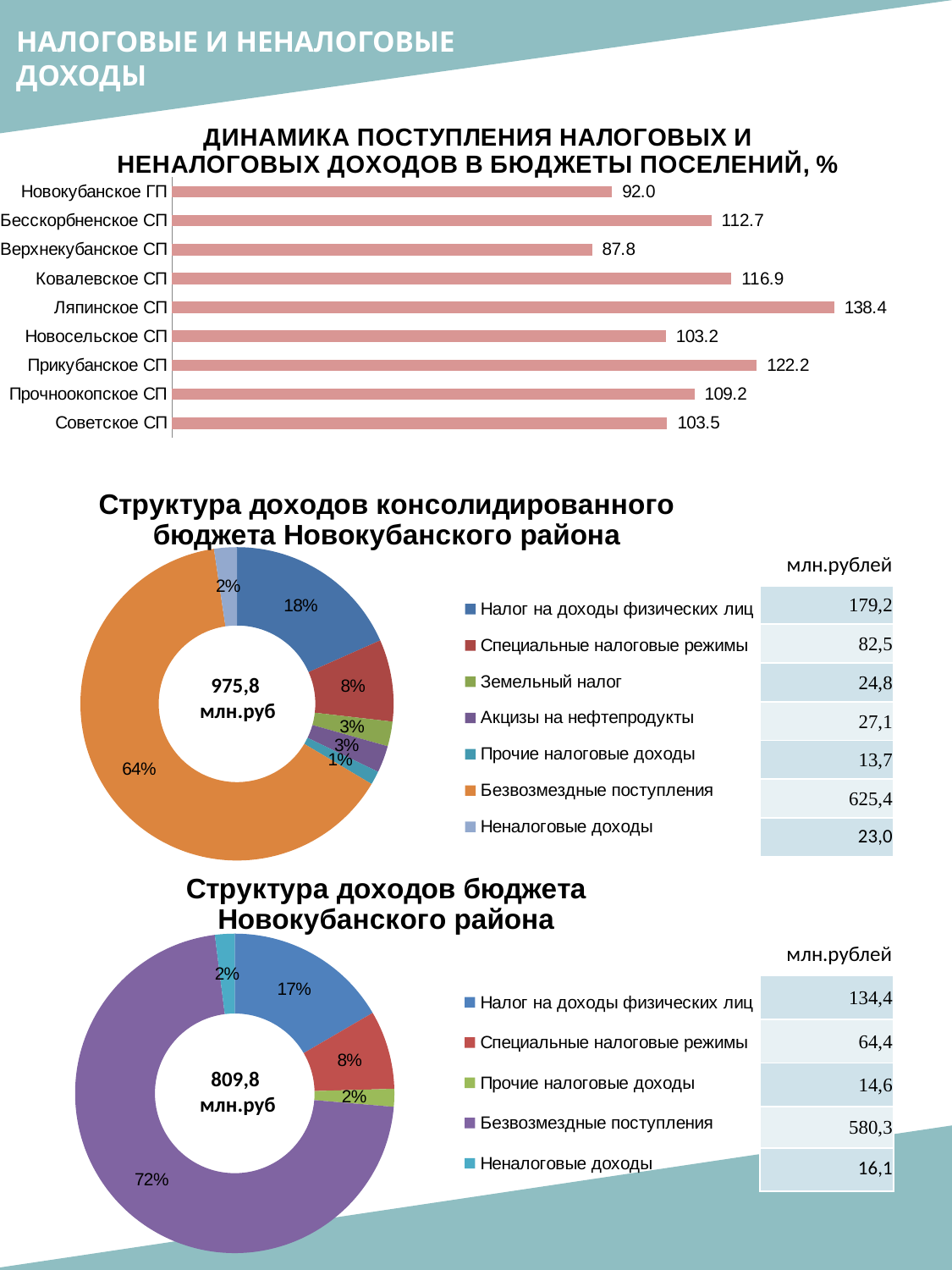
On the chart 'Структура доходов бюджета Новокубанского района', what is the value in млн.рублей for Безвозмездные поступления? 580,3 On the bar chart 'Динамика поступления налоговых и неналоговых доходов в бюджеты поселений, %', what is the value for Ляпинское СП? 138.4 On the chart 'Структура доходов консолидированного бюджета Новокубанского района', what share does Безвозмездные поступления have? 64% How many settlements are shown on the bar chart 'Динамика поступления налоговых и неналоговых доходов в бюджеты поселений, %'? 9 On the chart 'Структура доходов консолидированного бюджета Новокубанского района', what is the value in млн.рублей for Налог на доходы физических лиц? 179,2 What kind of chart is 'Динамика поступления налоговых и неналоговых доходов в бюджеты поселений, %'? Bar chart How many categories does the legend list for the chart 'Структура доходов консолидированного бюджета Новокубанского района'? 7 On the bar chart 'Динамика поступления налоговых и неналоговых доходов в бюджеты поселений, %', what is the difference between the values for Ляпинское СП and Верхнекубанское СП? 50.6 On the bar chart 'Динамика поступления налоговых и неналоговых доходов в бюджеты поселений, %', which is larger: the value for Бесскорбненское СП or for Прочноокопское СП? Бесскорбненское СП On the bar chart 'Динамика поступления налоговых и неналоговых доходов в бюджеты поселений, %', which settlement has the highest value? Ляпинское СП On the bar chart 'Динамика поступления налоговых и неналоговых доходов в бюджеты поселений, %', which settlement has the lowest value? Верхнекубанское СП What total is shown in the centre of the chart 'Структура доходов бюджета Новокубанского района'? 809,8 млн.руб